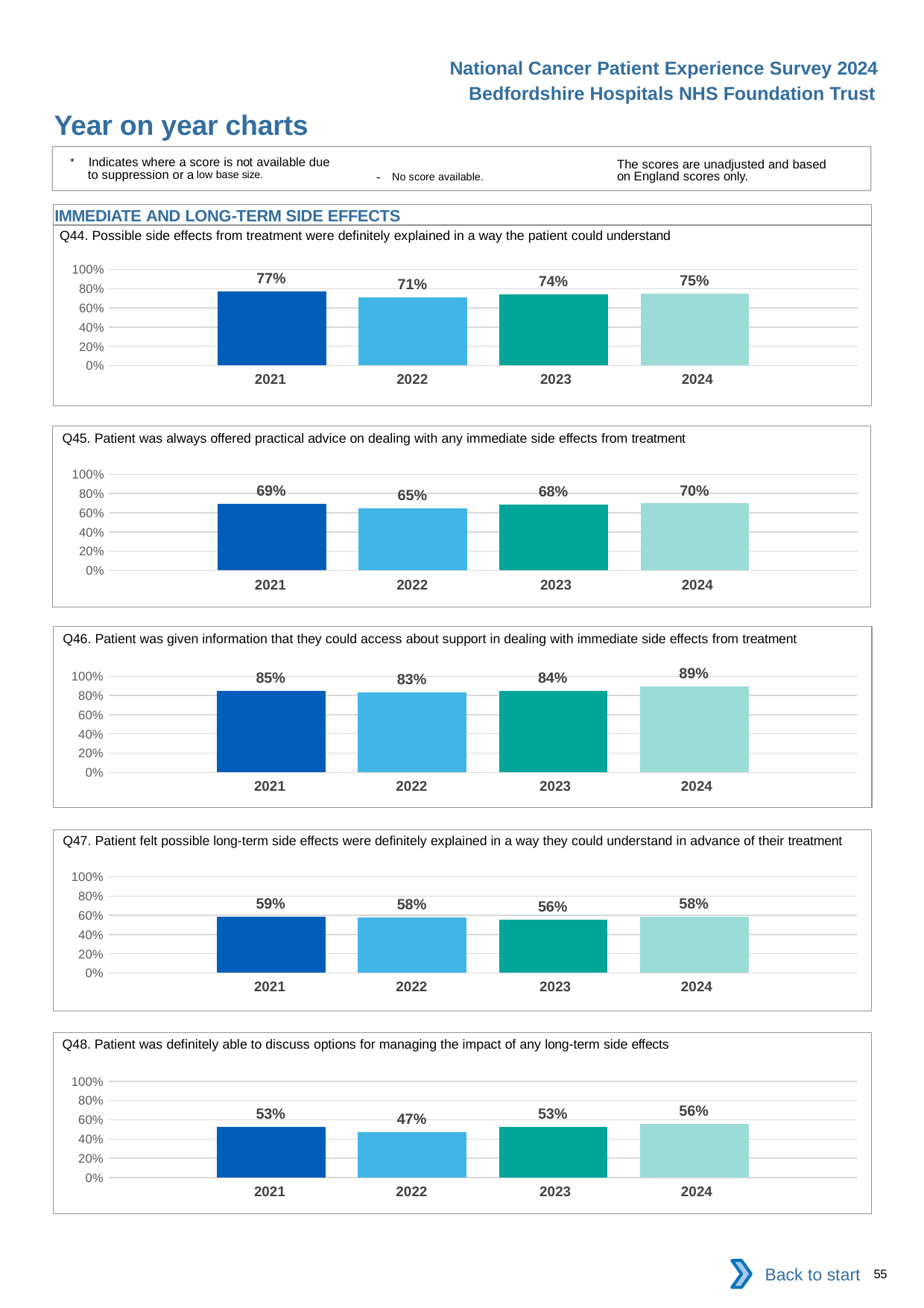
In the Q45 chart, which year has the highest value? 2024 In the Q48 chart, what is the value for 2022? 47% How many years are shown in the Q48 chart? 4 In the Q45 chart, what is the difference between the 2024 and 2022 values? 5% In the Q47 chart, is the value for 2021 greater or less than 80%? less In the Q46 chart, is the value for 2022 larger or smaller than the value for 2023? smaller In the Q46 chart, what is the value for 2024? 89% In the Q44 chart, what is the value for 2021? 77% In the Q44 chart, which year has the lowest value? 2022 In the Q48 chart, what is the difference between the 2024 and 2021 values? 3% What kind of chart is the Q44 chart? bar chart In the Q47 chart, what is the value for 2023? 56%